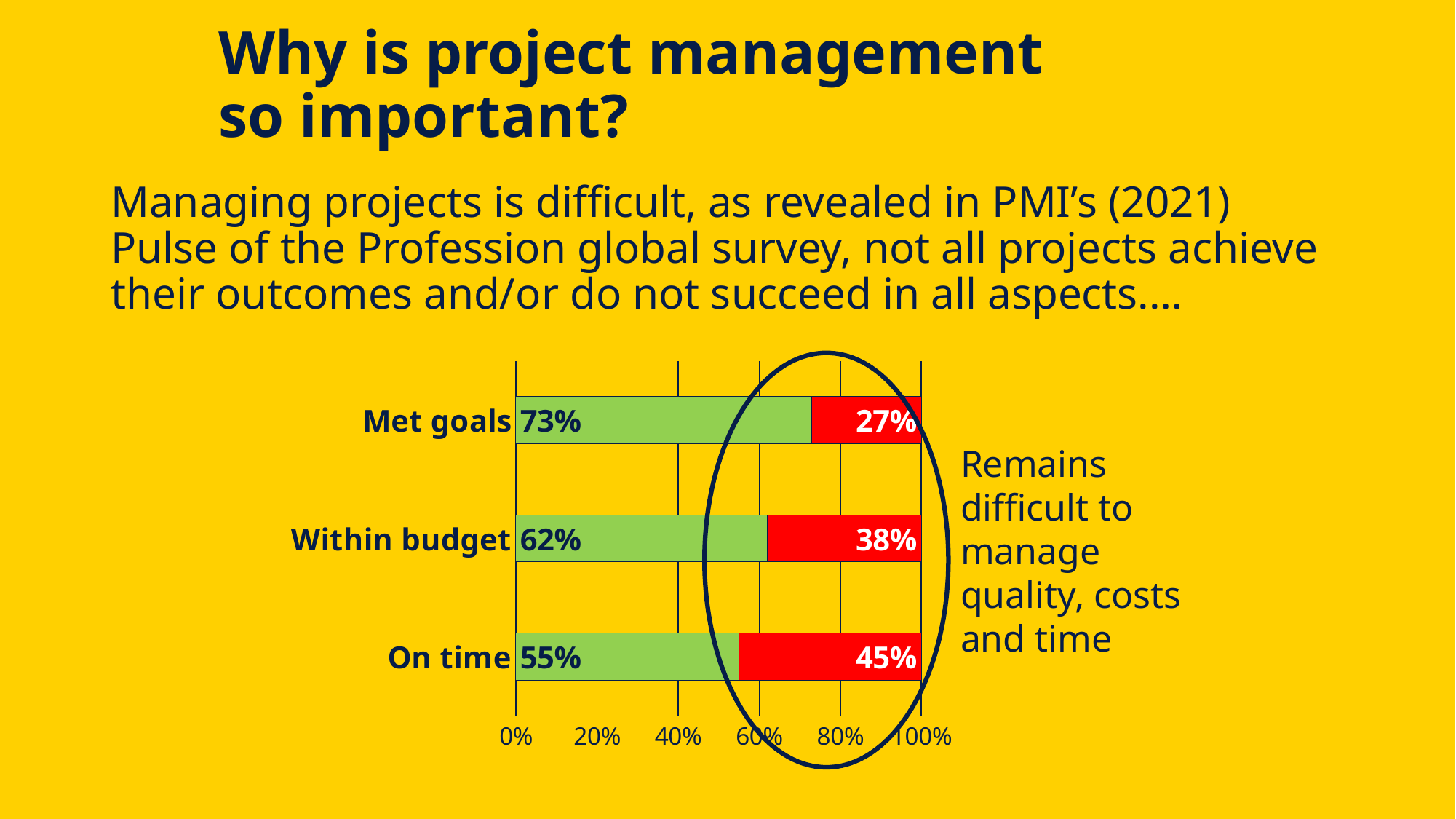
What is the green (achieved) value for Met goals? 73% What is the red (not achieved) value for Within budget? 38% What is the difference between the green values for Met goals and On time? 18% What is the green value for On time? 55% What is the highest value shown on the x axis of the chart? 100% Which is larger, the red value for Within budget or the red value for Met goals? Within budget What is the red value for On time? 45% What is the total of the stacked bar for Within budget? 100% Which category has the highest green (achieved) value? Met goals How many categories are shown on the chart? 3 Which category has the lowest green (achieved) value? On time What kind of chart is shown on the slide? Stacked bar chart